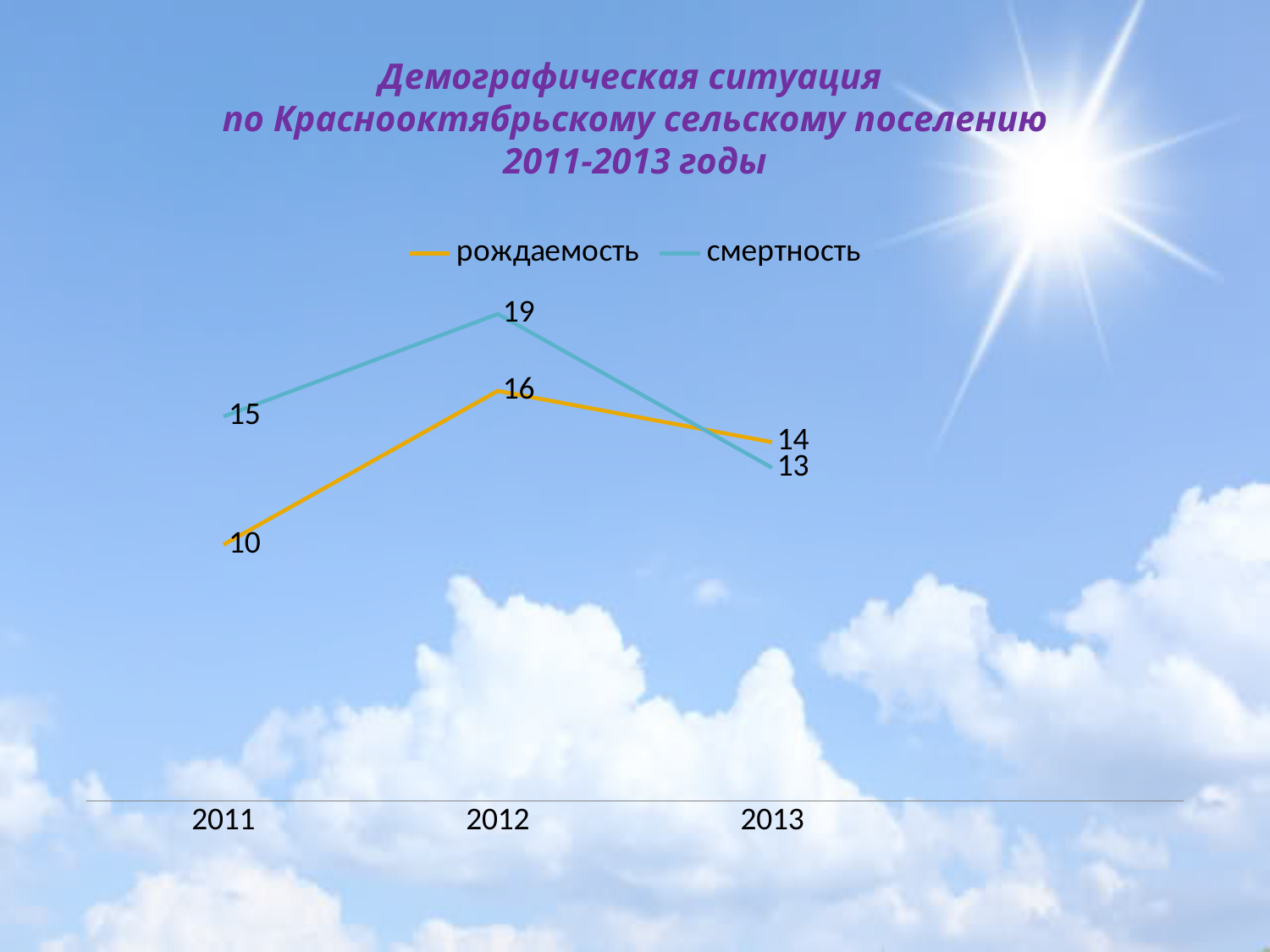
Which is larger in 2013, рождаемость or смертность? рождаемость What is the value for смертность in 2013? 13 Does смертность rise or fall from 2012 to 2013? fall What is the value for рождаемость in 2013? 14 In which year is смертность highest? 2012 How many years are shown on the x axis? 3 What kind of chart is shown on the slide? line chart How many series does the legend list? 2 What is the value for рождаемость in 2011? 10 In which year is рождаемость lowest? 2011 What is the value for смертность in 2012? 19 What is the difference between смертность and рождаемость in 2011? 5